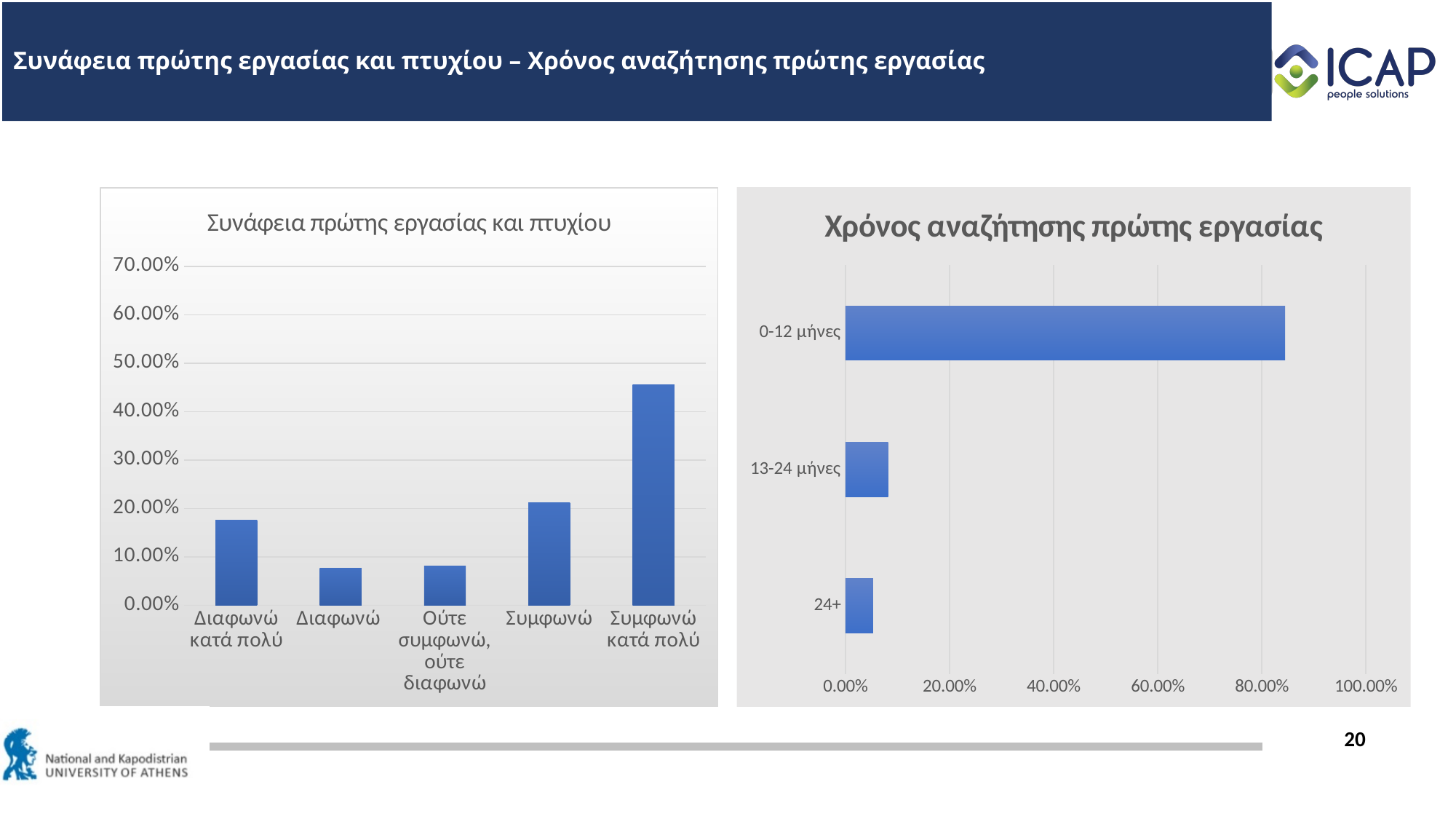
In the chart titled 'Συνάφεια πρώτης εργασίας και πτυχίου', is the value for 'Συμφωνώ κατά πολύ' greater or less than 40.00%? greater In the chart titled 'Συνάφεια πρώτης εργασίας και πτυχίου', which category has the highest value? Συμφωνώ κατά πολύ What is the title of the chart on the right side of the slide? Χρόνος αναζήτησης πρώτης εργασίας How many categories are shown in the chart titled 'Χρόνος αναζήτησης πρώτης εργασίας'? 3 What kind of chart is the chart titled 'Συνάφεια πρώτης εργασίας και πτυχίου'? bar chart In the chart titled 'Συνάφεια πρώτης εργασίας και πτυχίου', which is larger: the value for 'Διαφωνώ κατά πολύ' or the value for 'Διαφωνώ'? Διαφωνώ κατά πολύ In the chart titled 'Συνάφεια πρώτης εργασίας και πτυχίου', is the value for 'Διαφωνώ' greater or less than 10.00%? less In the chart titled 'Χρόνος αναζήτησης πρώτης εργασίας', is the value for '13-24 μήνες' greater or less than 20.00%? less How many categories are shown in the chart titled 'Συνάφεια πρώτης εργασίας και πτυχίου'? 5 In the chart titled 'Χρόνος αναζήτησης πρώτης εργασίας', which category has the highest value? 0-12 μήνες